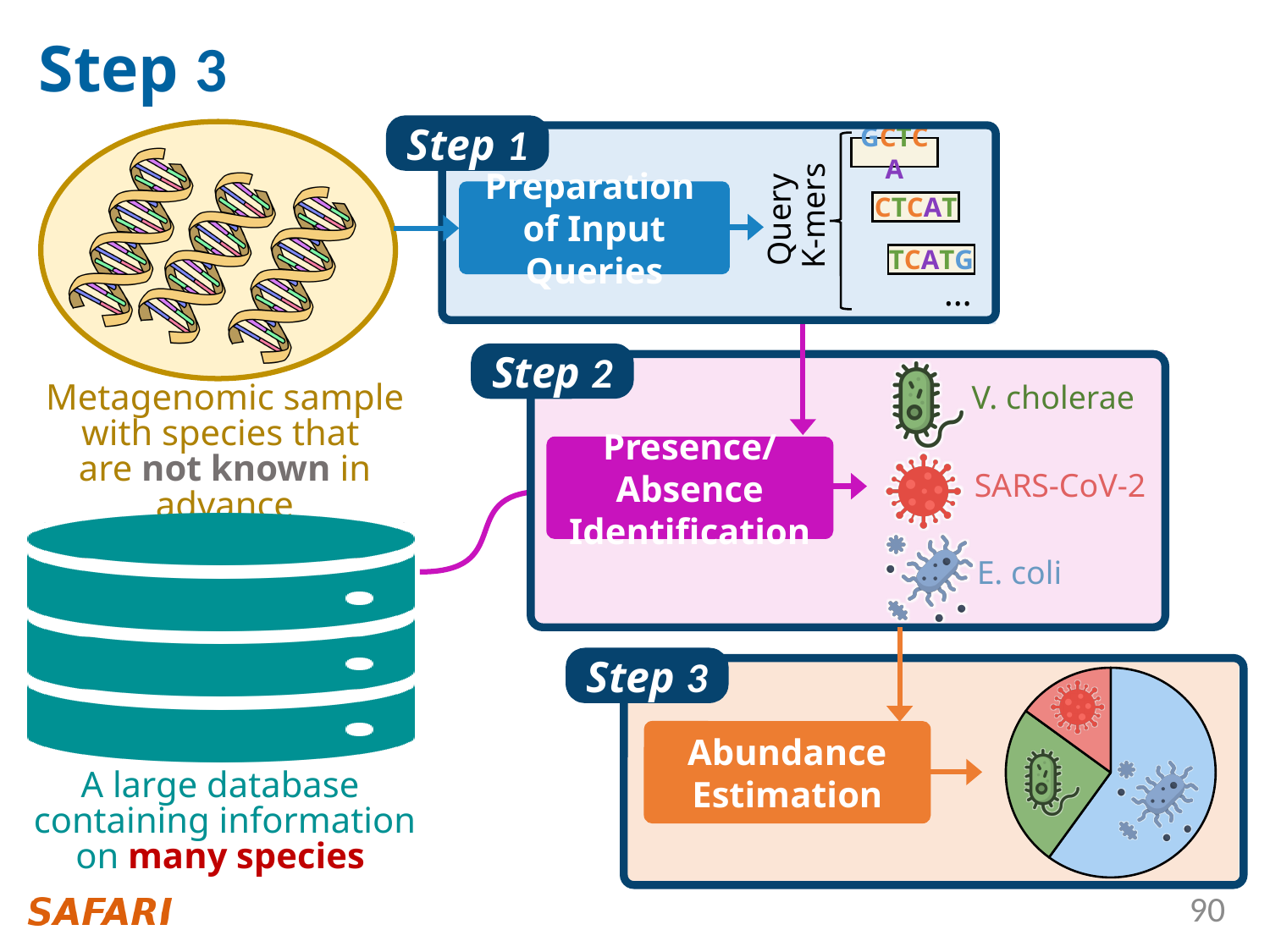
What kind of chart is shown in the Step 3 box on the slide? pie chart In the pie chart in the Step 3 box, which slice is the largest? the blue slice (E. coli icon) How many slices does the pie chart in the Step 3 box have? 3 In the pie chart in the Step 3 box, does the blue slice take up more or less than half of the pie? more In the pie chart in the Step 3 box, is the blue slice larger or smaller than the red slice? larger What colours are the three slices of the pie chart in the Step 3 box? red, green and blue Which process box feeds its output into the pie chart in the Step 3 box? Abundance Estimation